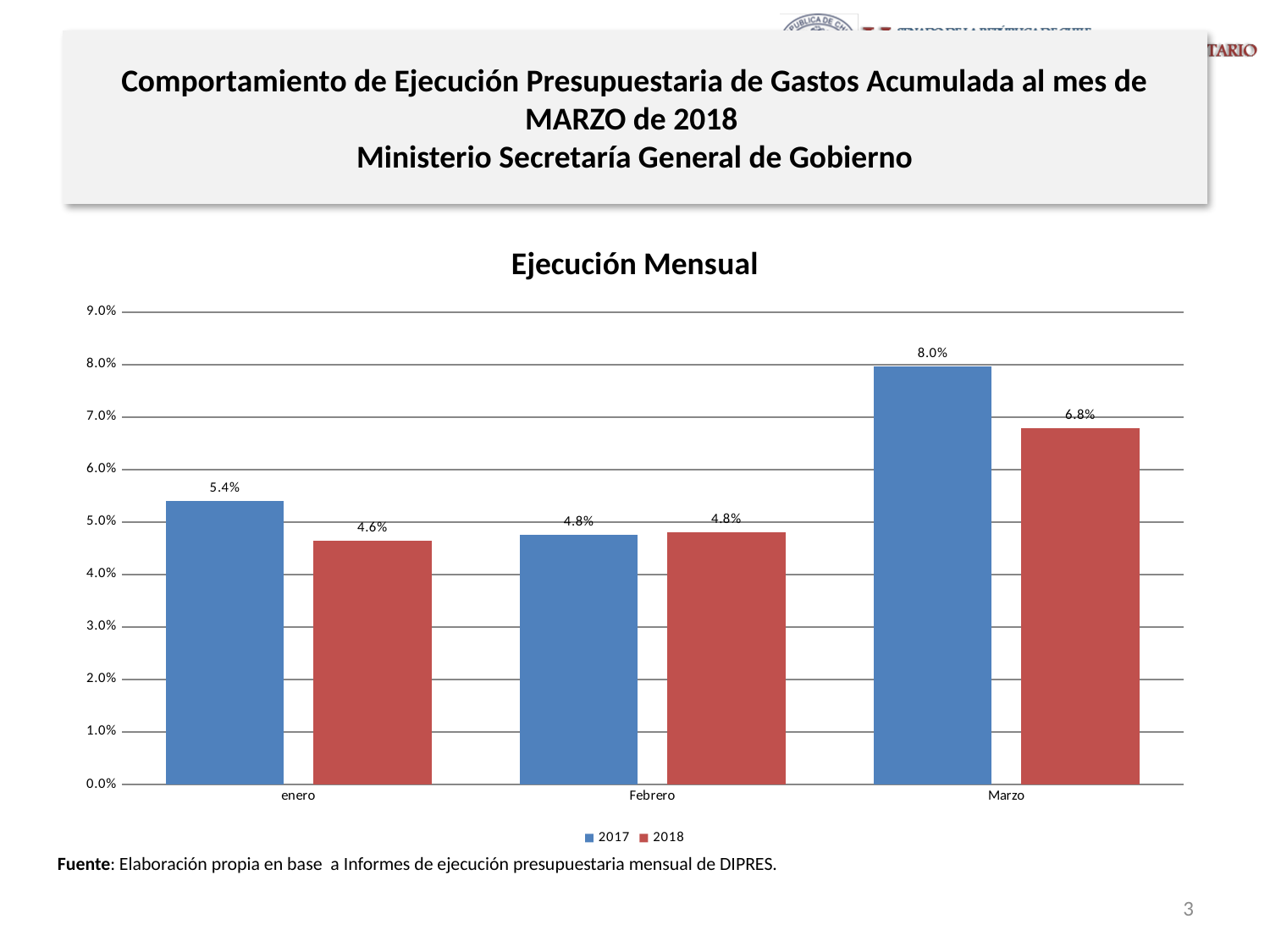
How many months are shown on the x axis? 3 What is the difference between the 2017 and 2018 values in Marzo? 1.2% What is the value for 2017 in enero? 5.4% What is the value for 2018 in Marzo? 6.8% What type of chart is shown? Bar chart Which month has the highest value for the 2017 series? Marzo Is the value for 2017 in Marzo greater or less than 7.0%? greater What is the value for 2018 in enero? 4.6% How many series does the legend list? 2 What is the value for 2017 in Marzo? 8.0% Which is larger in enero, the 2017 value or the 2018 value? 2017 Which month has the lowest value for the 2018 series? enero